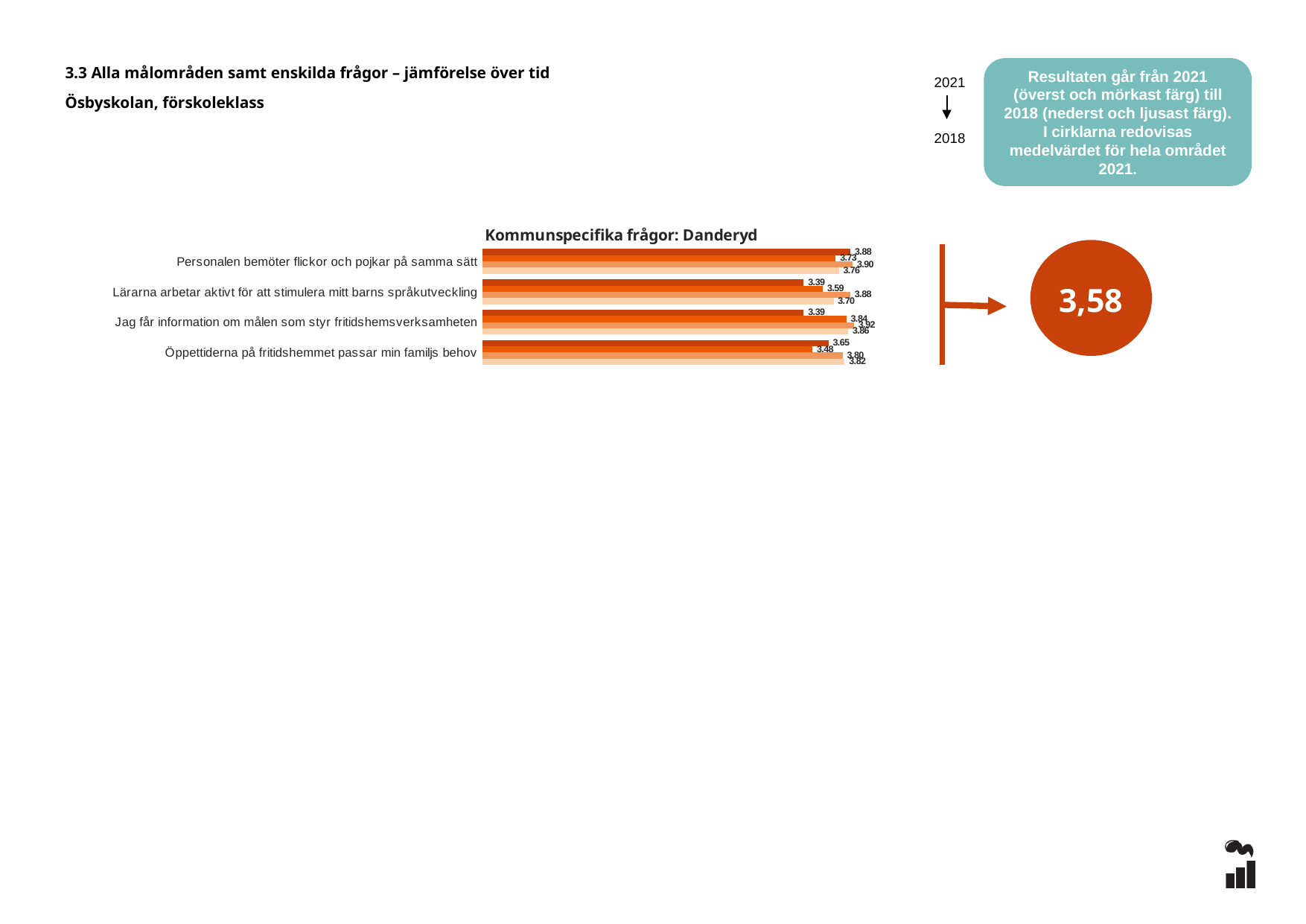
What is the 2021 value (top, darkest bar) for 'Lärarna arbetar aktivt för att stimulera mitt barns språkutveckling'? 3.39 What mean value for the whole area in 2021 is shown in the circle next to the chart? 3,58 Which category has the highest 2021 value (top, darkest bar)? Personalen bemöter flickor och pojkar på samma sätt What is the difference between the 2021 values for 'Personalen bemöter flickor och pojkar på samma sätt' and 'Öppettiderna på fritidshemmet passar min familjs behov'? 0.23 What is the 2021 value (top, darkest bar) for 'Öppettiderna på fritidshemmet passar min familjs behov'? 3.65 What kind of chart is shown on the slide? bar chart What is the 2021 value (top, darkest bar) for 'Personalen bemöter flickor och pojkar på samma sätt'? 3.88 What is the title of the chart? Kommunspecifika frågor: Danderyd Which is larger: the 2021 value for 'Öppettiderna på fritidshemmet passar min familjs behov' or the 2021 value for 'Jag får information om målen som styr fritidshemsverksamheten'? Öppettiderna på fritidshemmet passar min familjs behov How many categories (questions) are shown in the chart? 4 What is the 2018 value (bottom, lightest bar) for 'Öppettiderna på fritidshemmet passar min familjs behov'? 3.82 What is the 2018 value (bottom, lightest bar) for 'Jag får information om målen som styr fritidshemsverksamheten'? 3.86